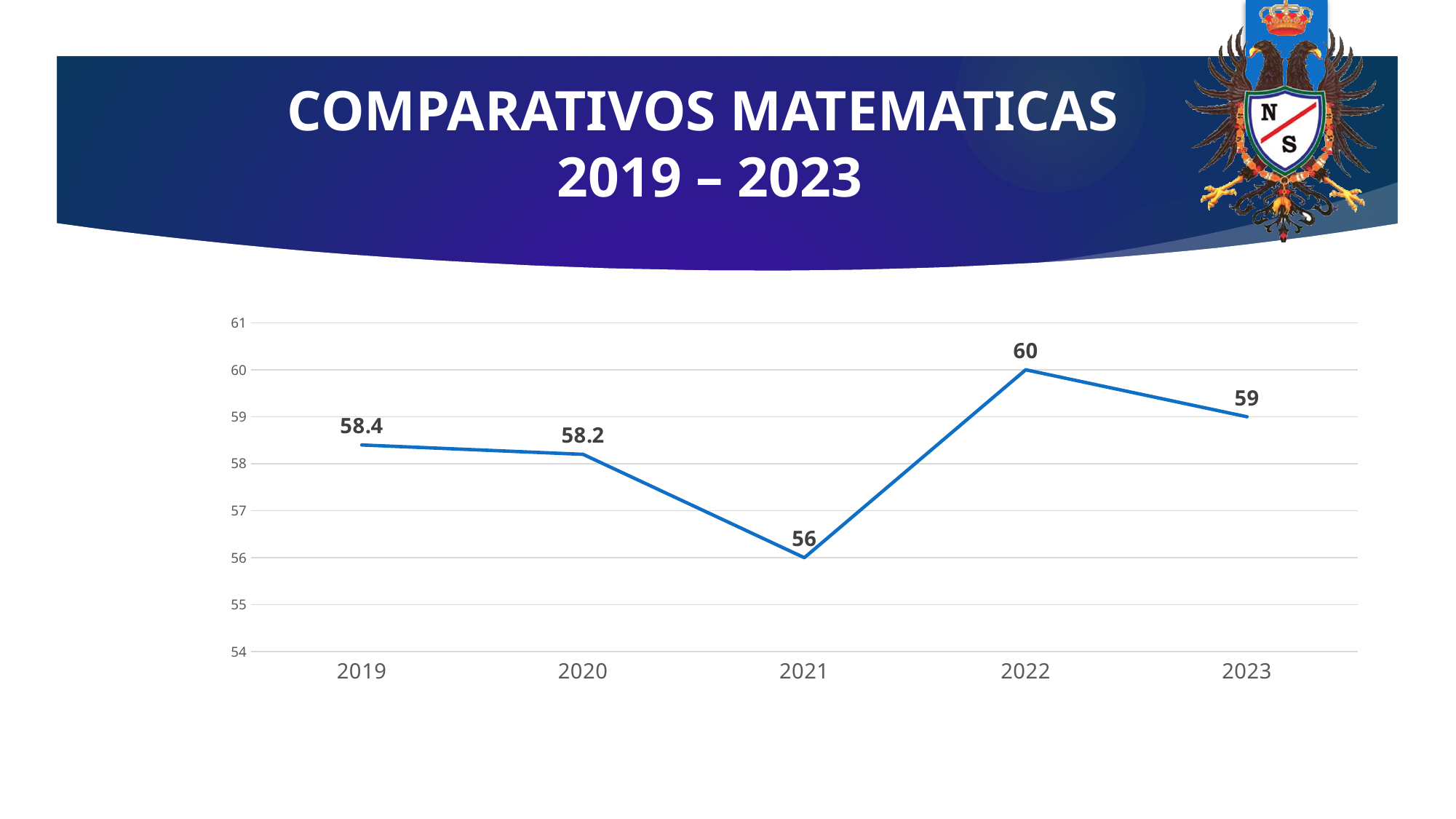
Which year has the highest value? 2022 Is the value for 2021 greater or less than 57? less What is the difference between the values for 2022 and 2021? 4 Does the value rise or fall from 2022 to 2023? fall What kind of chart is shown on the slide? line chart What is the value for 2021? 56 What is the difference between the values for 2019 and 2020? 0.2 How many years are plotted on the chart? 5 Which is larger, the value for 2020 or the value for 2023? 2023 Which year has the lowest value? 2021 What is the value for 2023? 59 What is the value for 2019? 58.4